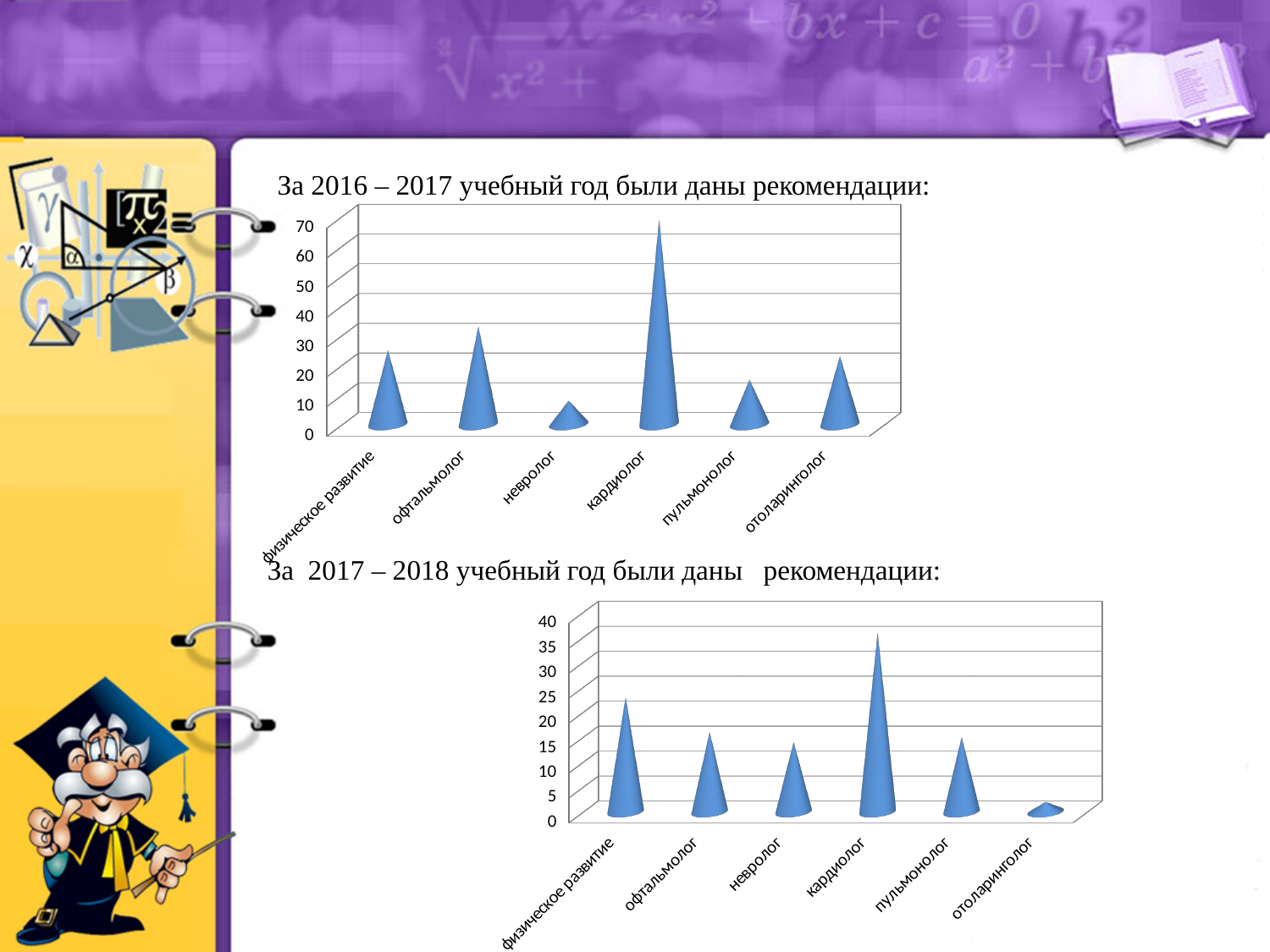
In the bottom chart (2017–2018), is the value for отоларинголог greater or less than 5? less In the top chart (2016–2017), which category has the highest value? кардиолог In the bottom chart (2017–2018), which category has the lowest value? отоларинголог In the top chart (2016–2017), is the value for невролог greater or less than 10? less In the bottom chart (2017–2018), is the value for кардиолог greater or less than 30? greater How many categories are shown in the top chart (2016–2017)? 6 In the top chart (2016–2017), which category has the lowest value? невролог In the top chart (2016–2017), which is larger: the value for офтальмолог or for физическое развитие? офтальмолог In the bottom chart (2017–2018), which category has the highest value? кардиолог What kind of chart is the bottom chart (2017–2018)? bar chart In the bottom chart (2017–2018), which is larger: the value for физическое развитие or for офтальмолог? физическое развитие